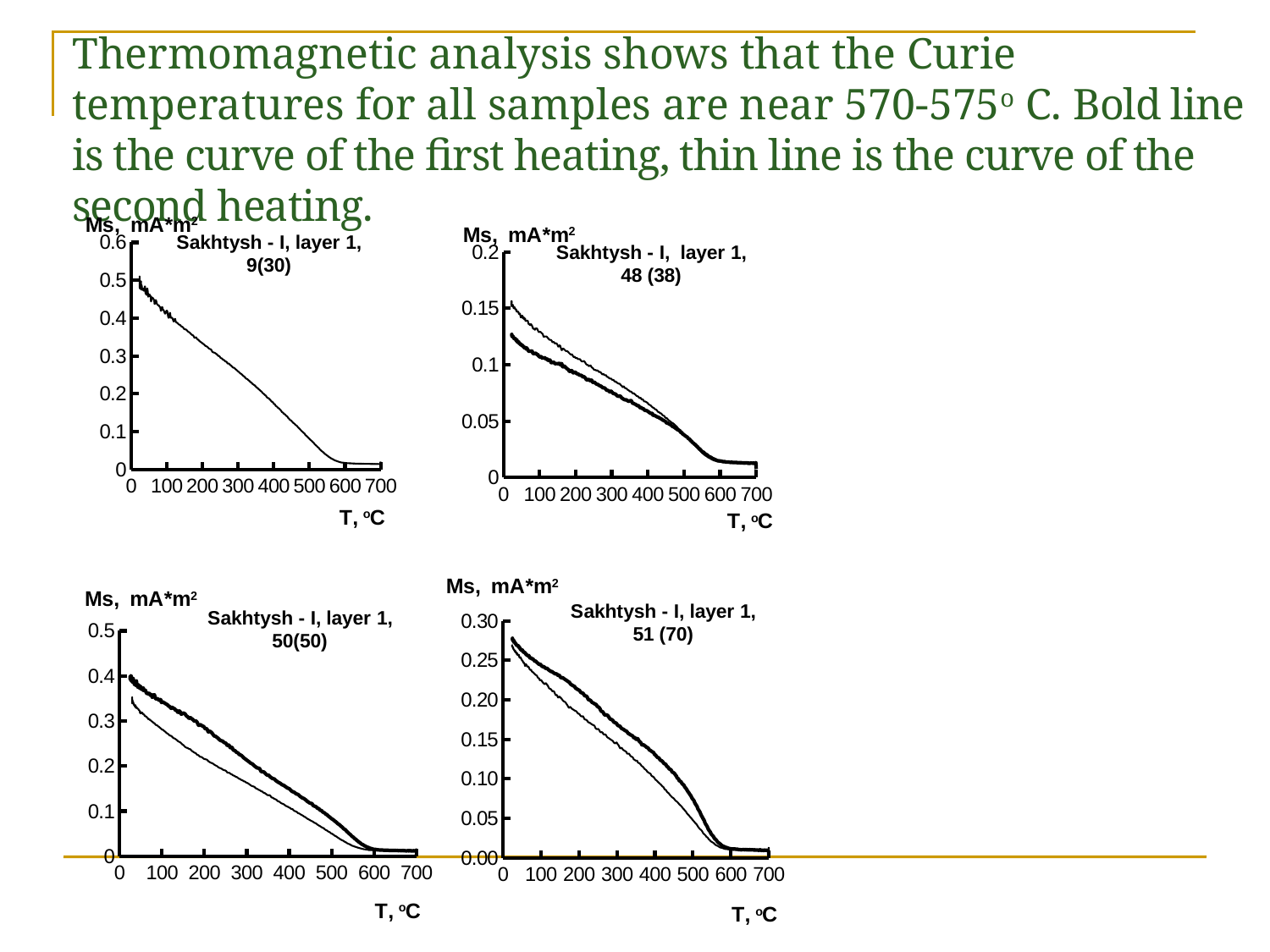
In the bottom-right chart "Sakhtysh - I, layer 1, 51 (70)", is the bold-line Ms value at 100 °C greater or less than 0.20? greater What is the label of the x axis on the bottom-right chart "Sakhtysh - I, layer 1, 51 (70)"? T, °C In the top-left chart "Sakhtysh - I, layer 1, 9(30)", is the Ms value at 100 °C greater or less than 0.3? greater In the bottom-left chart "Sakhtysh - I, layer 1, 50(50)", is the Ms value at 600 °C greater or less than 0.1? less How many charts are shown on the slide? 4 What kind of chart is the top-left chart titled "Sakhtysh - I, layer 1, 9(30)"? line chart In the top-left chart "Sakhtysh - I, layer 1, 9(30)", do the Ms values rise or fall as temperature increases along the x axis? fall In the bottom-right chart "Sakhtysh - I, layer 1, 51 (70)", do the Ms values rise or fall as temperature increases? fall What is the label of the y axis on the top-left chart "Sakhtysh - I, layer 1, 9(30)"? Ms, mA*m²